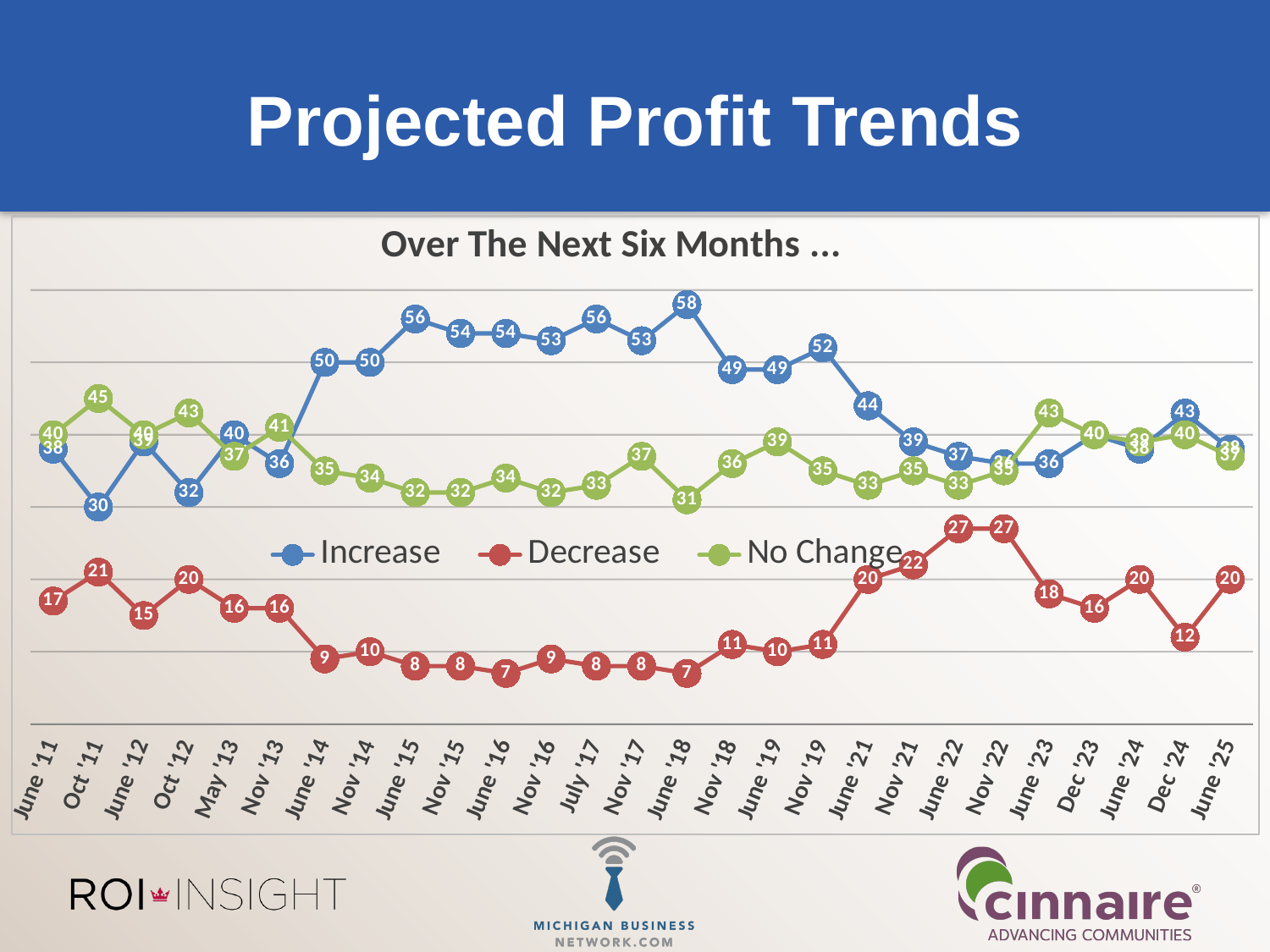
What type of chart is shown on the slide? line chart What is the value of the Decrease series for Dec '24? 12 In which period does the Increase series reach its highest value? June '18 What is the value of the No Change series for Oct '11? 45 In which period does the No Change series reach its lowest value? June '18 What is the difference between the Increase value and the Decrease value for June '18? 51 What is the value of the Increase series for June '18? 58 What is the title of the chart? Over The Next Six Months ... How many series does the legend list? 3 In which period does the Increase series reach its lowest value? Oct '11 Which is larger for Dec '24: the Increase value or the No Change value? Increase What is the value of the Decrease series for June '22? 27